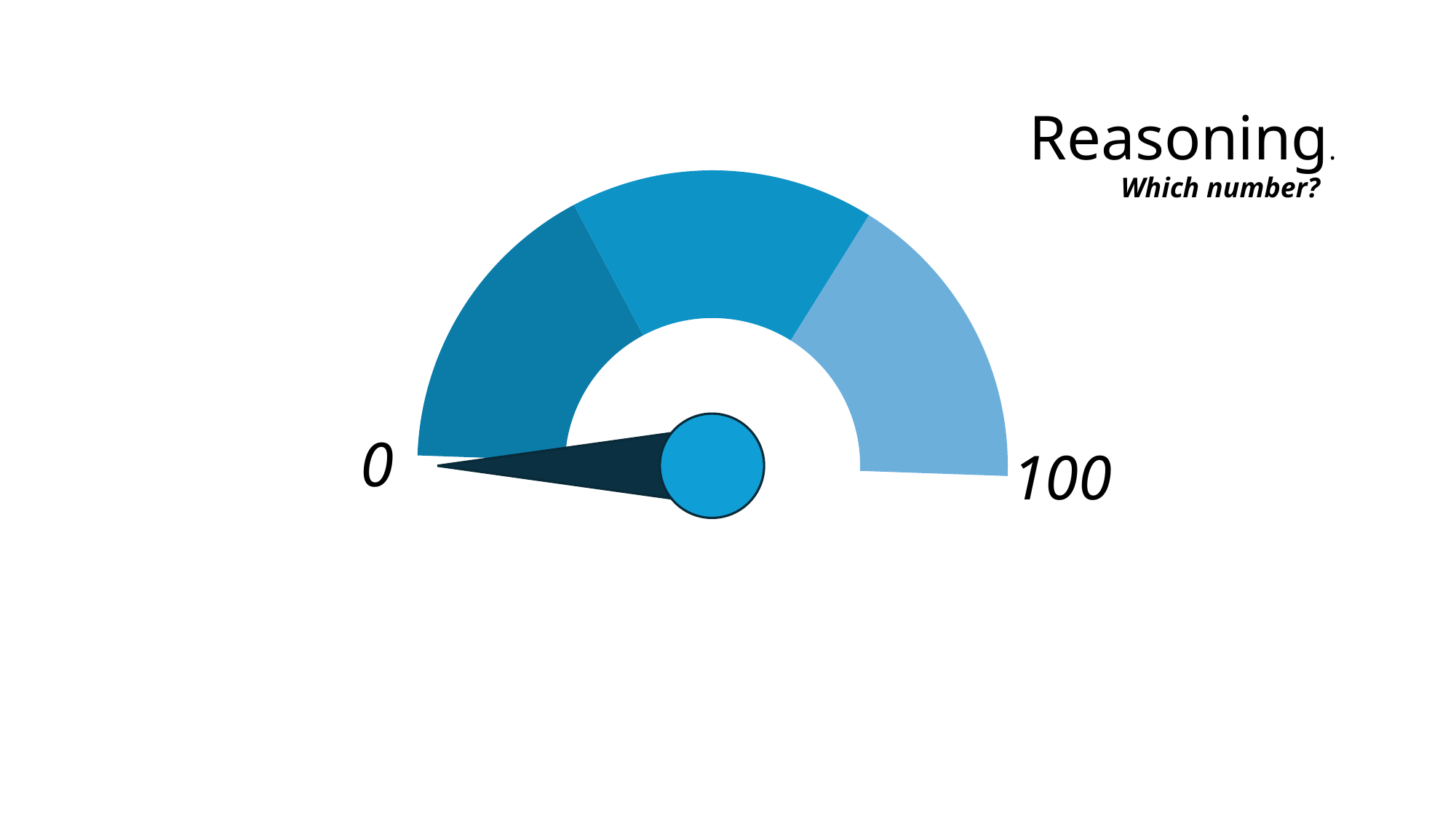
What question is written beneath the title? Which number? Is the value the needle points to greater or less than 50? less Which end of the scale is the needle pointing toward, 0 or 100? 0 What is the highest value labelled on the gauge scale? 100 What kind of chart is shown on the slide? gauge chart How many coloured segments make up the gauge arc? 3 What is the lowest value labelled on the gauge scale? 0 What is the title text shown on the slide? Reasoning.